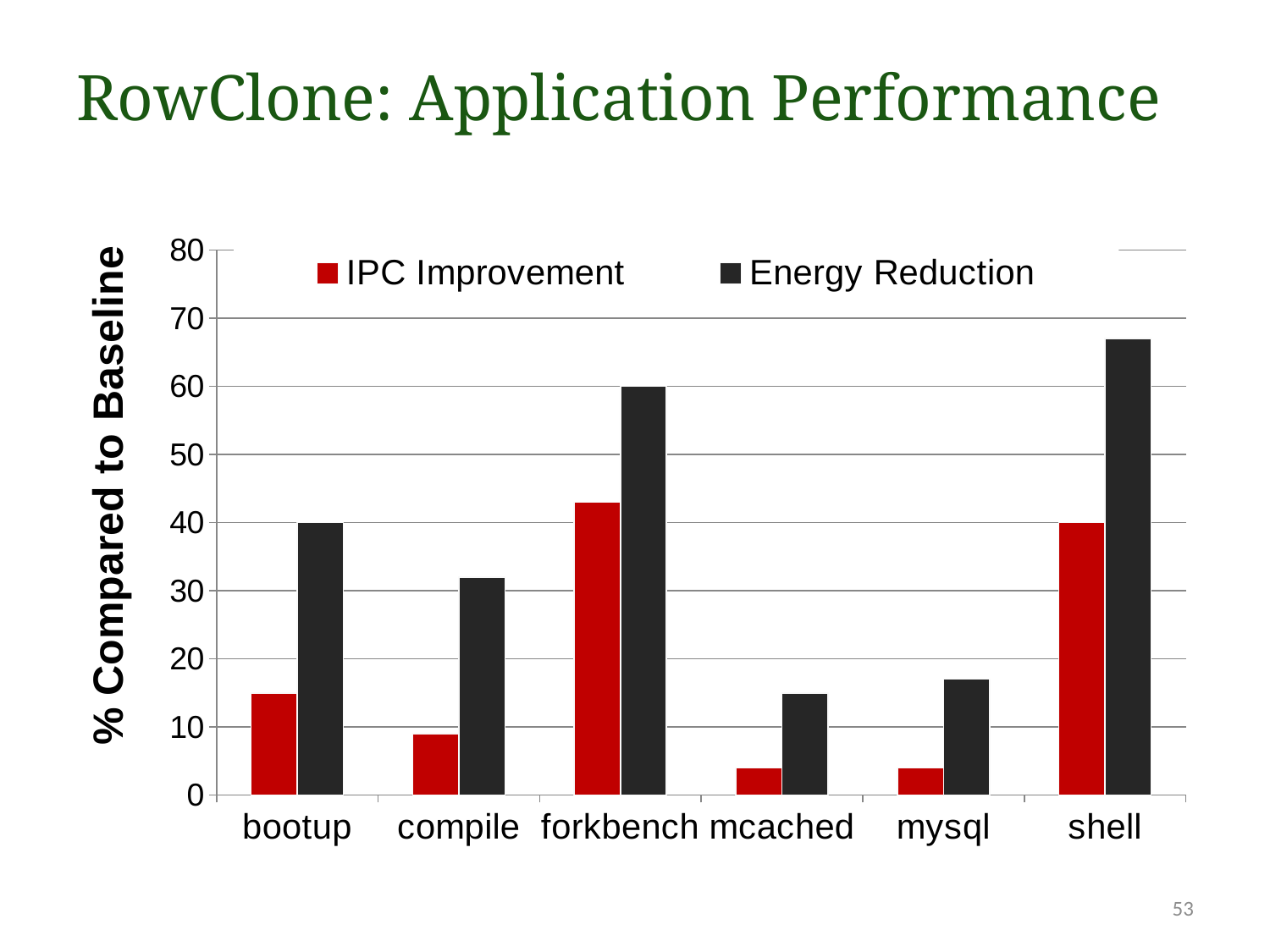
How many applications are shown on the x axis? 6 Which is larger, the IPC Improvement for bootup or for compile? bootup Is the Energy Reduction for shell greater or less than 60? greater Which is larger, the Energy Reduction for forkbench or for mysql? forkbench Is the IPC Improvement for mcached greater or less than 10? less Is the IPC Improvement for compile greater or less than 10? less What type of chart is shown on the slide? bar chart How many series does the legend list? 2 Which application has the highest IPC Improvement? forkbench Which application has the highest Energy Reduction? shell What is the label of the y axis? % Compared to Baseline